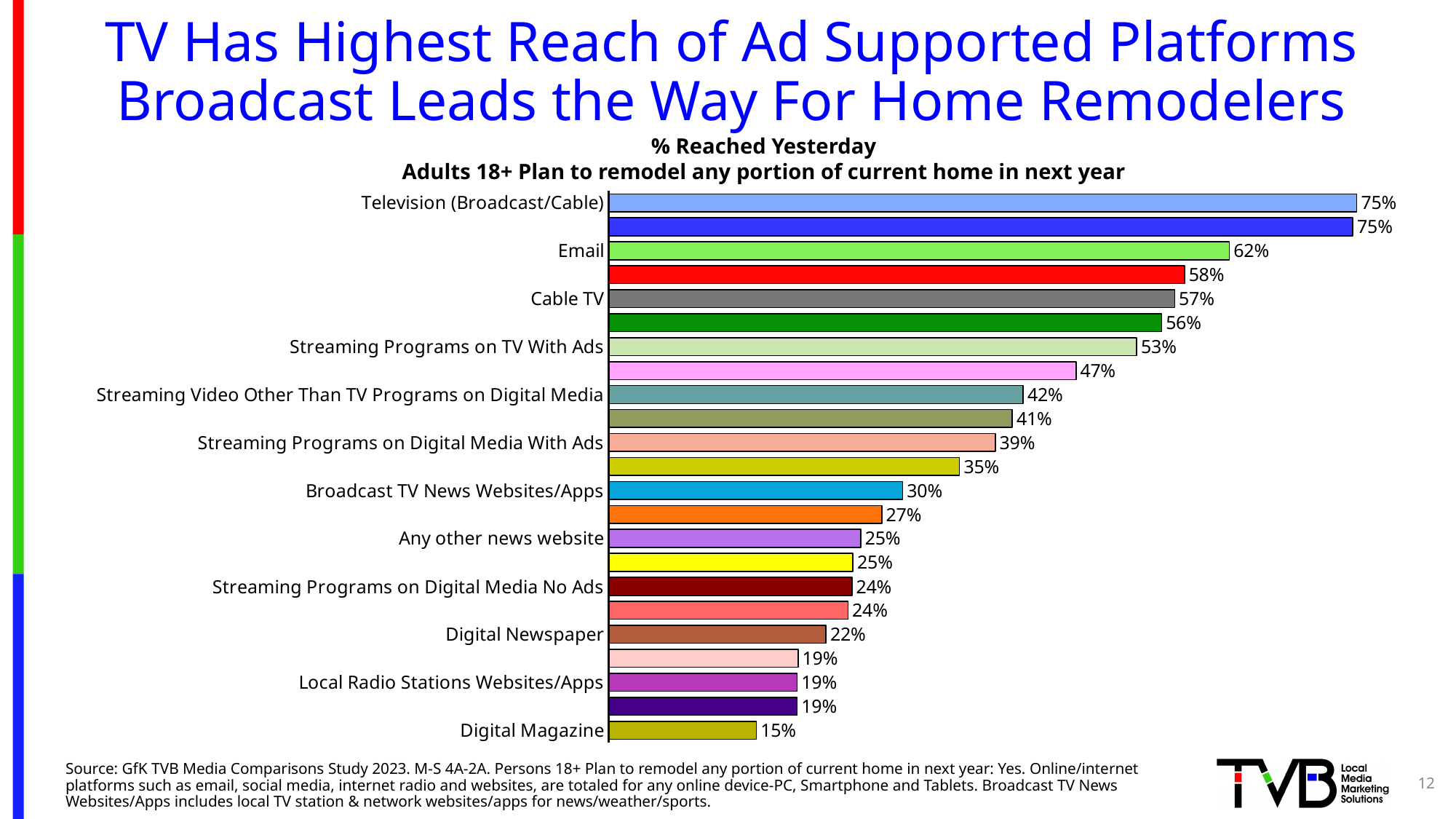
What is the value for Digital Newspaper? 22% What is the highest value shown in the chart? 75% What kind of chart is shown on the slide? Bar chart Which is larger, the value for Streaming Programs on Digital Media With Ads or the value for Any other news website? Streaming Programs on Digital Media With Ads What is the value for Streaming Programs on TV With Ads? 53% Which labeled category has the lowest value? Digital Magazine What is the first line of the chart's title? % Reached Yesterday What is the value for Email? 62% What is the difference between the values for Television (Broadcast/Cable) and Email? 13% What is the value for Broadcast TV News Websites/Apps? 30% What is the value for Cable TV? 57% How many bars are plotted in the chart? 23